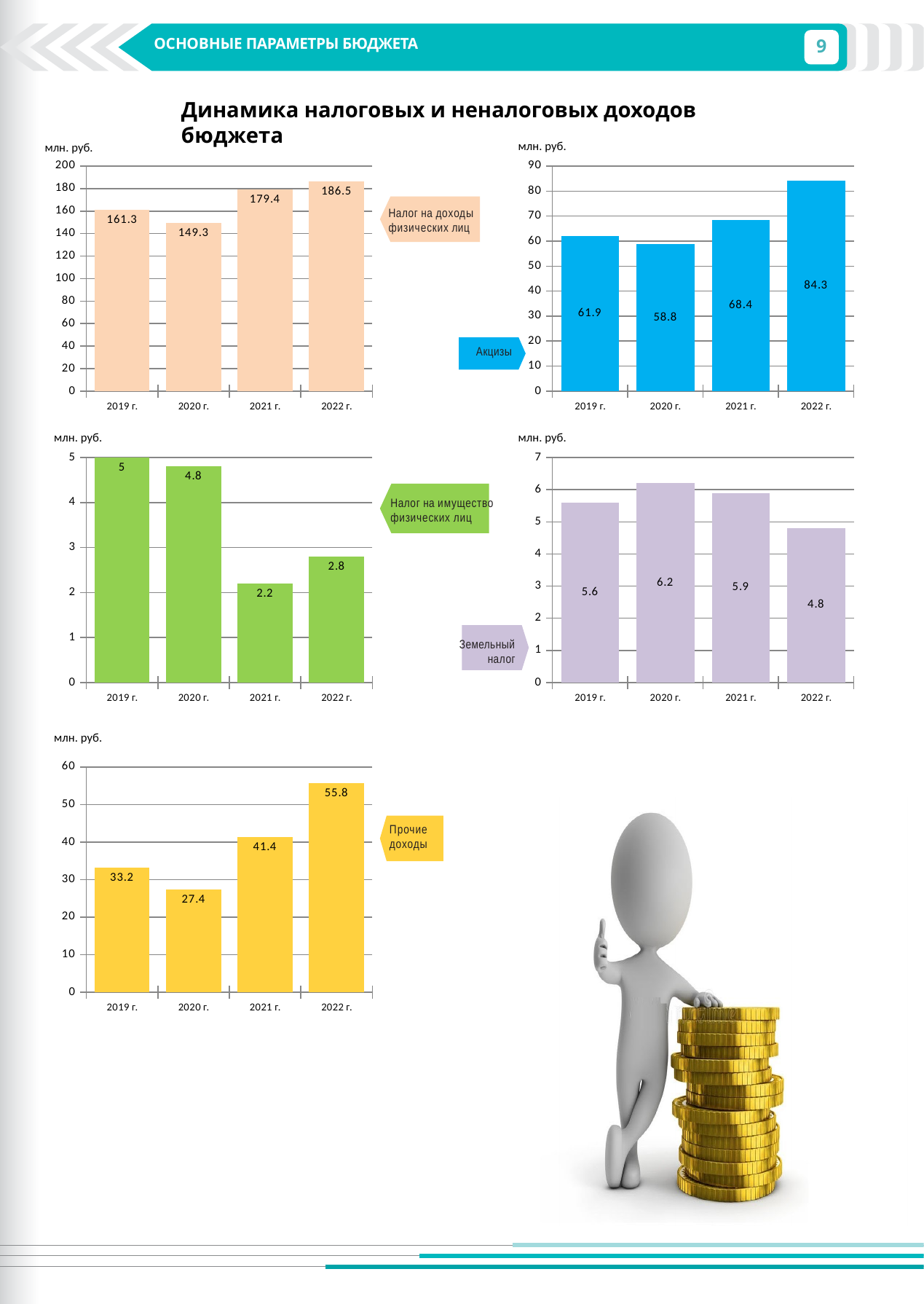
What unit is shown above the y axis of each chart on the slide? млн. руб. In the 'Прочие доходы' chart, what is the value for 2022 г.? 55.8 In the 'Прочие доходы' chart, is the value for 2021 г. larger or smaller than the value for 2019 г.? larger In the 'Акцизы' chart, what is the value for 2020 г.? 58.8 In the 'Налог на доходы физических лиц' chart, what is the value for 2022 г.? 186.5 In the 'Земельный налог' chart, which year has the highest value? 2020 г. In the 'Земельный налог' chart, what is the difference between the 2020 г. and 2022 г. values? 1.4 In the 'Акцизы' chart, which year has the highest value? 2022 г. In the 'Налог на имущество физических лиц' chart, which year has the lowest value? 2021 г. How many years are shown on the x axis of the 'Земельный налог' chart? 4 In the 'Налог на доходы физических лиц' chart, what is the difference between the 2021 г. and 2020 г. values? 30.1 What type of chart is the 'Акцизы' chart? bar chart